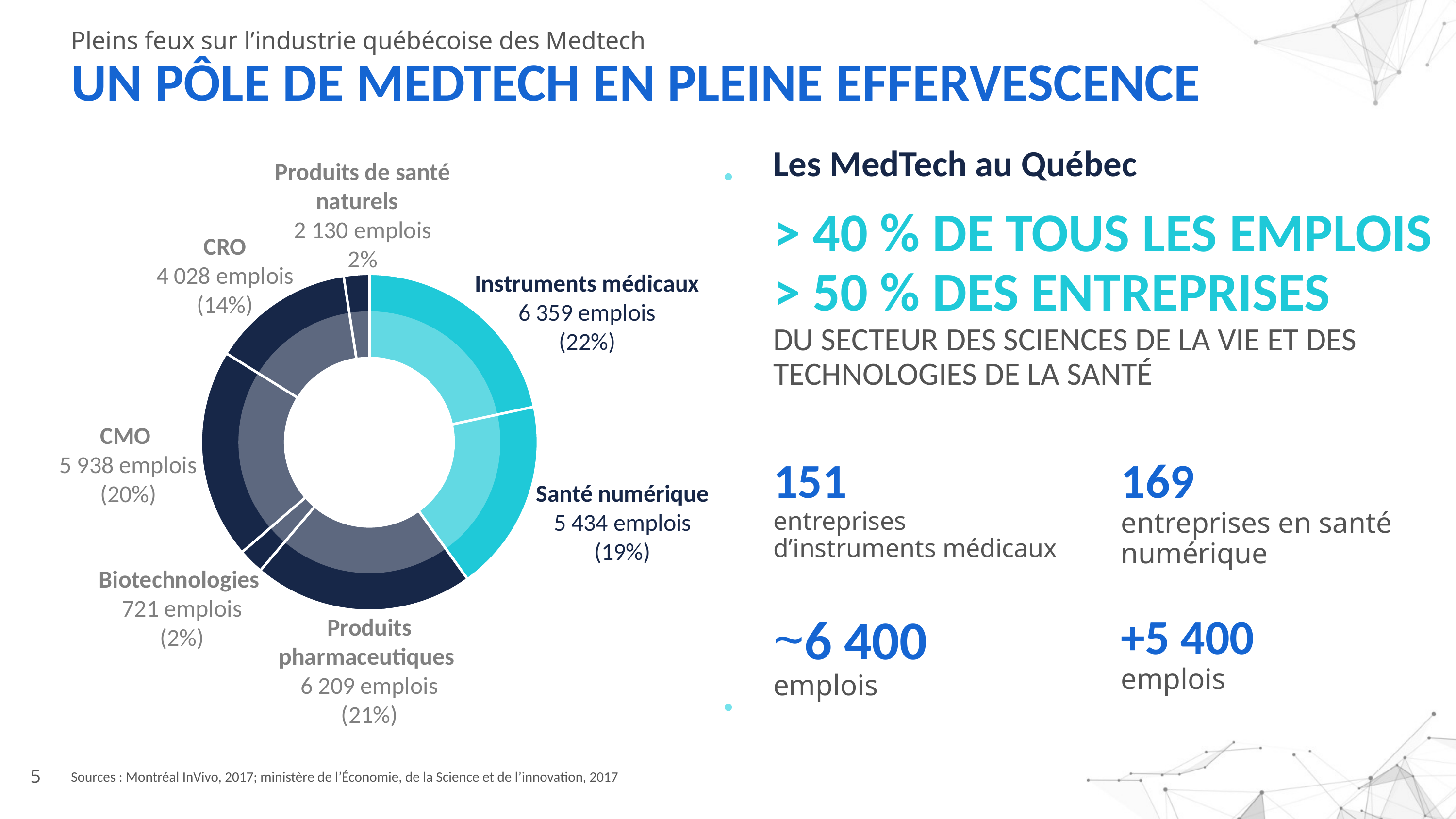
Which category has the highest number of jobs? Instruments médicaux What share of the donut does Santé numérique represent? 19% How many jobs are shown for CRO? 4 028 emplois Which has more jobs, Produits de santé naturels or Biotechnologies? Produits de santé naturels Which category has the lowest number of jobs? Biotechnologies Which two categories are shown in turquoise/cyan colours on the donut chart? Instruments médicaux and Santé numérique What share of the donut does CMO represent? 20% What is the difference in jobs between Instruments médicaux and Santé numérique? 925 How many jobs (emplois) are shown for Produits pharmaceutiques? 6 209 emplois What kind of chart is shown on the left of the slide? Donut (pie) chart How many categories does the donut chart show? 7 What is the difference in jobs between CMO and CRO? 1 910